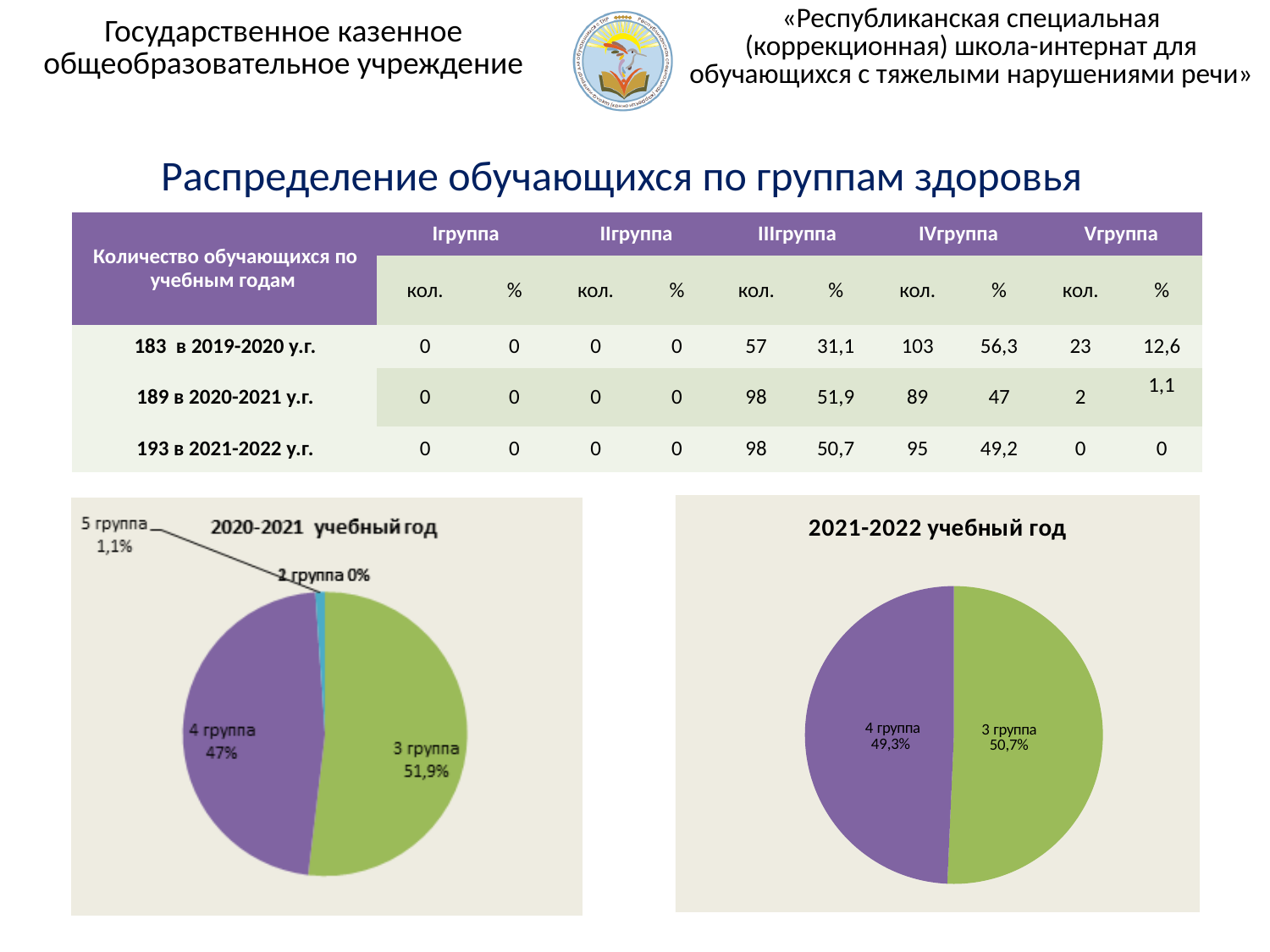
In the chart titled "2020-2021 учебный год", what is the share for 4 группа? 47% In the chart titled "2020-2021 учебный год", what is the share for 3 группа? 51,9% What type of chart is the one titled "2021-2022 учебный год"? Pie chart In the chart titled "2021-2022 учебный год", what is the difference in percentage points between 3 группа and 4 группа? 1,4 In the chart titled "2020-2021 учебный год", what is the share for 5 группа? 1,1% In the chart titled "2021-2022 учебный год", what is the share for 3 группа? 50,7% In the chart titled "2021-2022 учебный год", what colour is the slice for 4 группа? Purple In the chart titled "2021-2022 учебный год", what is the share for 4 группа? 49,3% In the chart titled "2020-2021 учебный год", which group has the largest slice? 3 группа In the chart titled "2020-2021 учебный год", which labelled group has the smallest share? 2 группа How many labelled slices does the chart titled "2021-2022 учебный год" have? 2 In the chart titled "2020-2021 учебный год", what is the difference in percentage points between 3 группа and 4 группа? 4,9